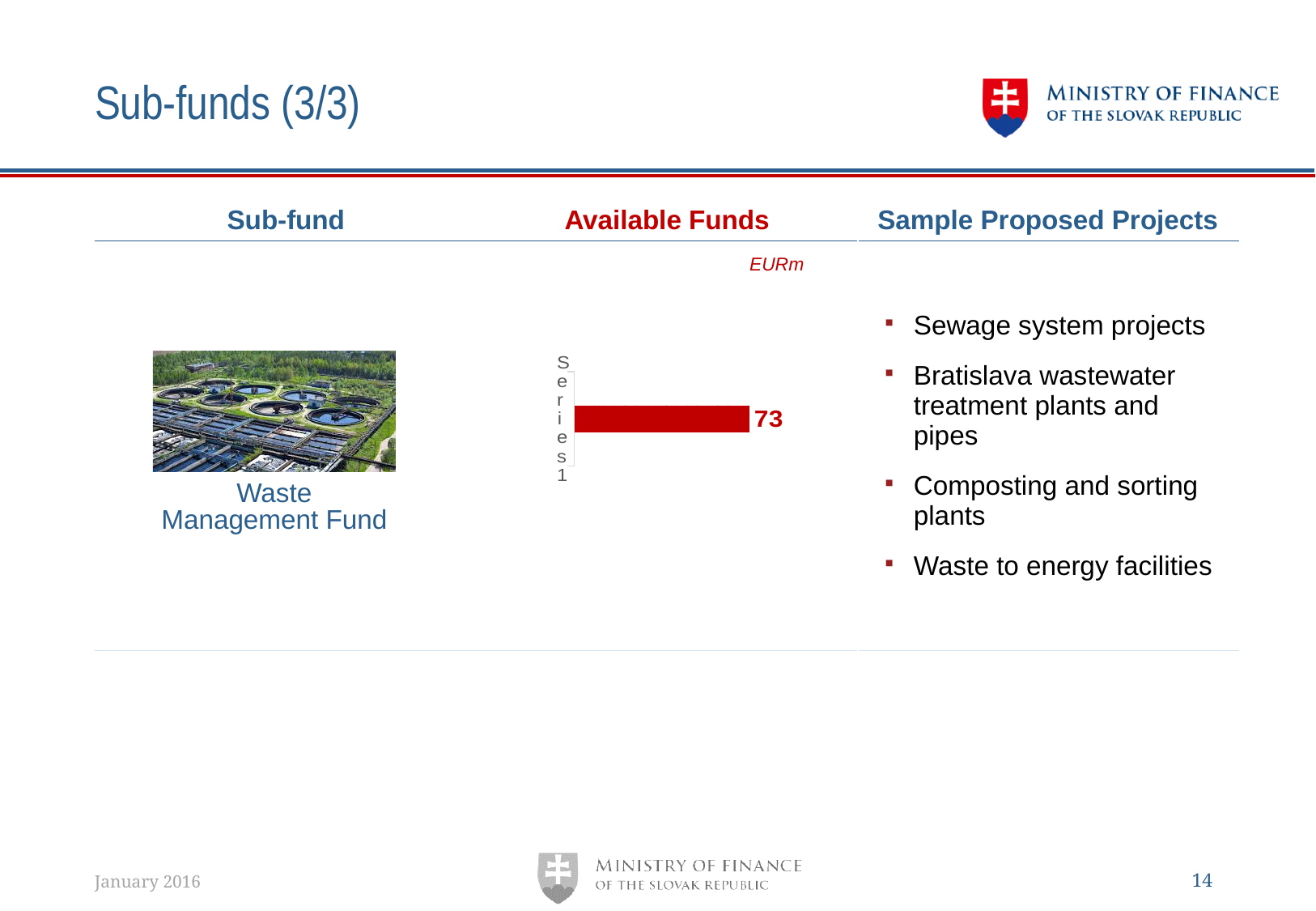
What unit is indicated above the Available Funds chart? EURm Which sub-fund does the Available Funds chart with the value 73 belong to? Waste Management Fund What kind of chart is used to show the Available Funds? bar chart What is the category label shown next to the bar in the Available Funds chart? Series 1 How many bars does the Available Funds chart contain? 1 What value is shown on the bar in the Available Funds chart? 73